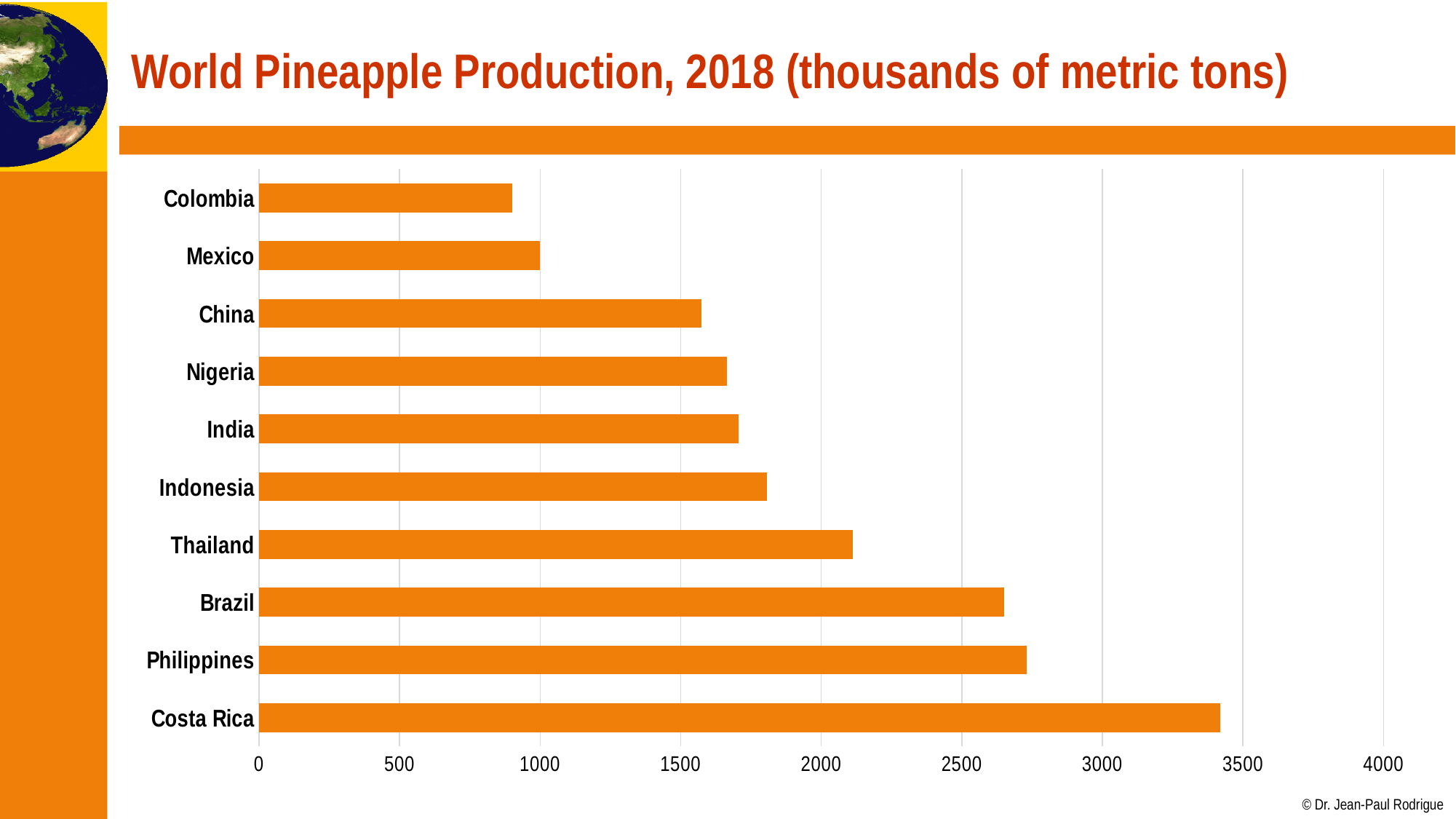
Which has a larger value, Indonesia or China? Indonesia Is the value for Colombia greater or less than 1000? less What kind of chart is shown on the slide? bar chart Is the value for Indonesia greater or less than 2000? less What is the title of the chart on the slide? World Pineapple Production, 2018 (thousands of metric tons) Which country has the lowest pineapple production in the chart? Colombia Which has a larger value, Brazil or Thailand? Brazil How many countries are shown in the chart? 10 Which country has the highest pineapple production in the chart? Costa Rica Is the value for Philippines greater or less than 3000? less